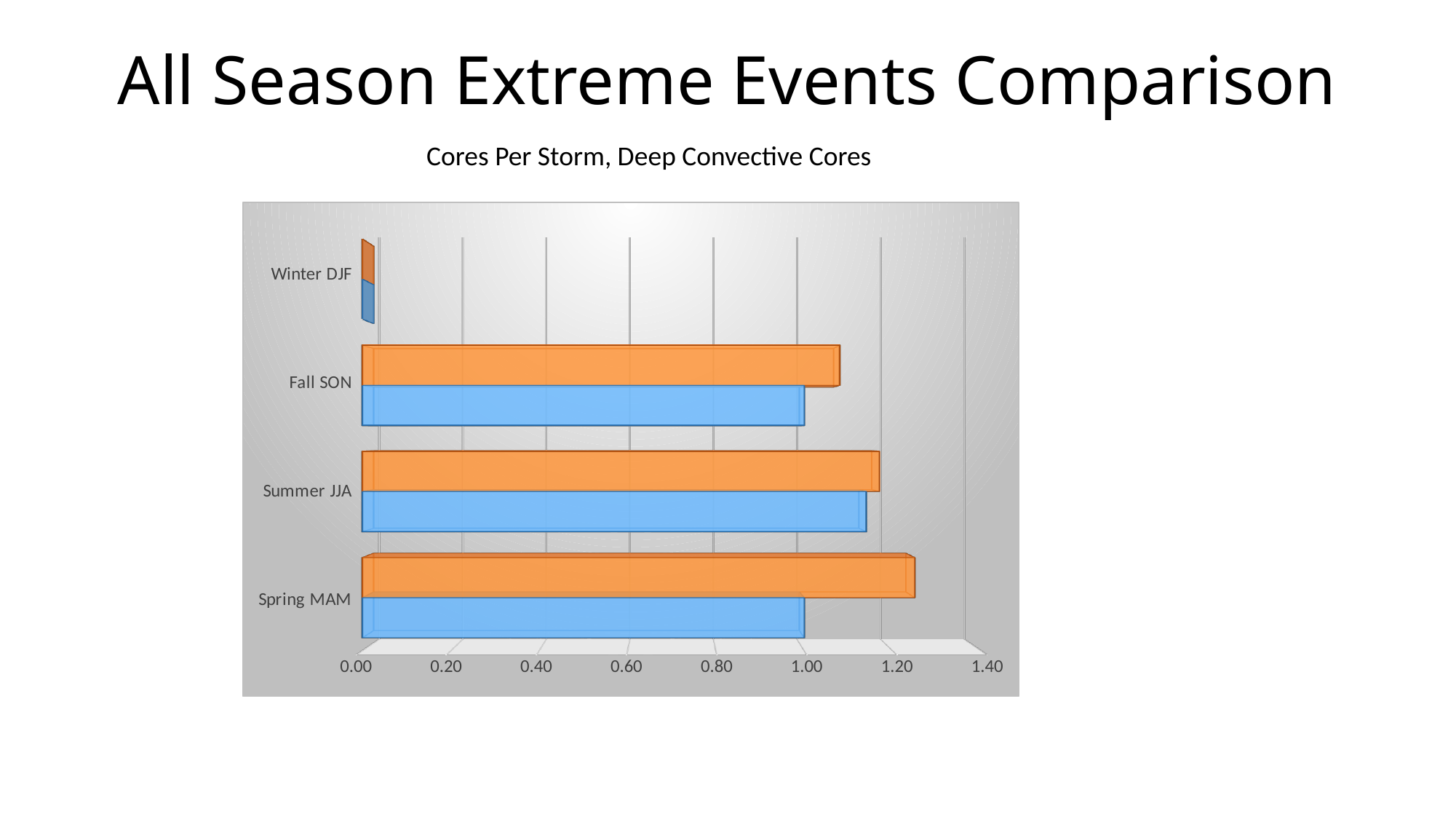
Which season has the shortest blue bar? Winter DJF Which season has the longest blue bar? Summer JJA Which season has the longest orange bar? Spring MAM Which is larger, the orange bar for Spring MAM or the orange bar for Summer JJA? Spring MAM Which season has the shortest orange bar? Winter DJF What kind of chart is shown on the slide? bar chart How many bars are shown for each season category? 2 How many season categories are shown on the chart? 4 Is the orange bar for Winter DJF greater or less than 0.20? less Is the orange bar for Spring MAM greater or less than 1.20? greater What is the title of the chart? Cores Per Storm, Deep Convective Cores Is the blue bar for Summer JJA greater or less than 1.00? greater